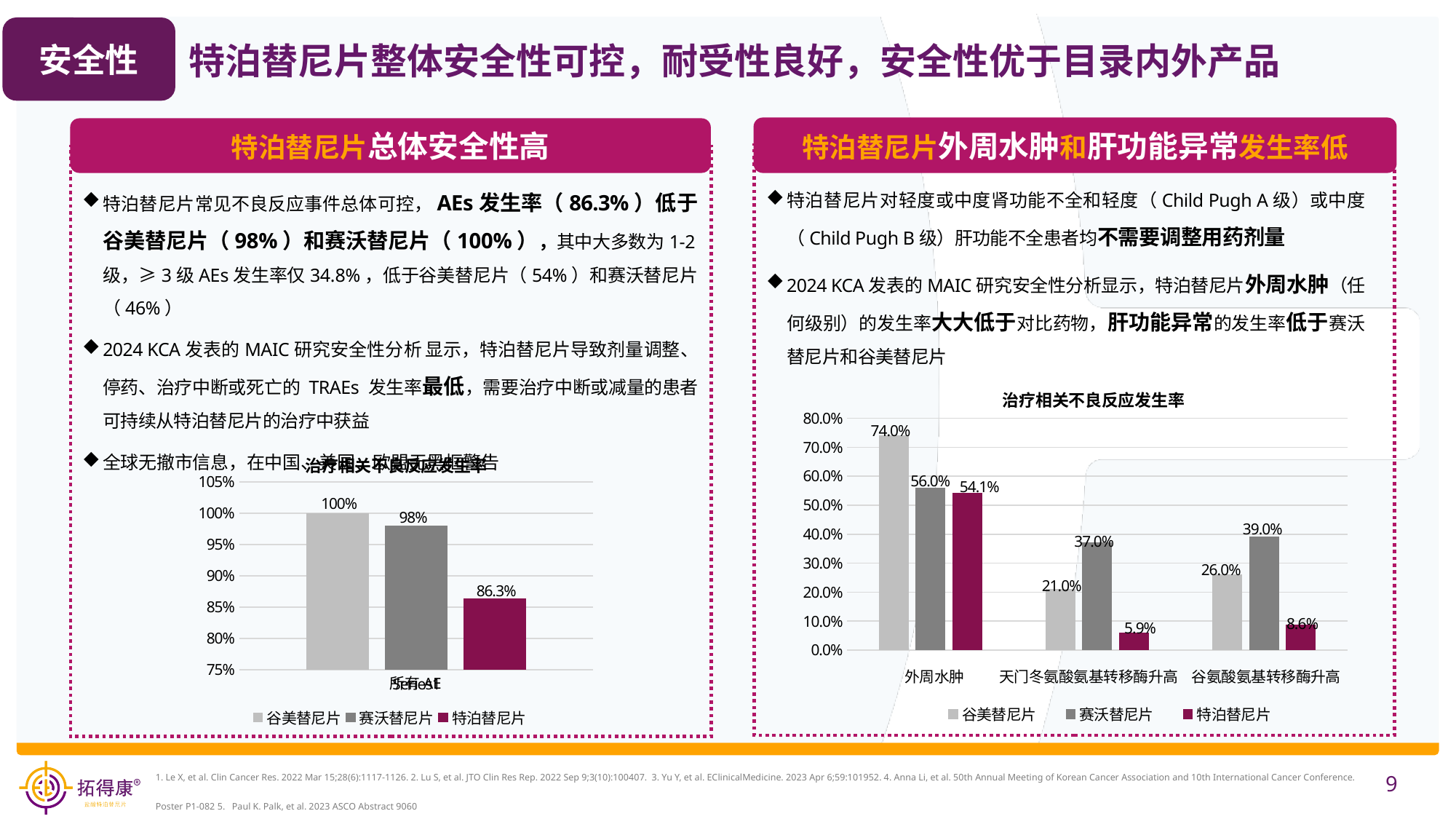
In the right chart, what is the value for 特泊替尼片 in the 外周水肿 category? 54.1% In the right chart, what is the value for 赛沃替尼片 in the 谷氨酸氨基转移酶升高 category? 39.0% In the right chart, what is the difference between 谷美替尼片 and 特泊替尼片 in the 外周水肿 category? 19.9% In the left chart, what is the value for 特泊替尼片? 86.3% In the left chart, what is the difference between the values for 谷美替尼片 and 特泊替尼片? 13.7% In the right chart, which series has the lowest value in the 天门冬氨酸氨基转移酶升高 category? 特泊替尼片 In the left chart, how many series does the legend list? 3 In the right chart, which series has the highest value in the 外周水肿 category? 谷美替尼片 In the left chart, which series has the highest value? 谷美替尼片 What kind of chart is the right chart? bar chart In the right chart, how many categories are shown on the x axis? 3 In the right chart, which is larger in the 谷氨酸氨基转移酶升高 category: 谷美替尼片 or 赛沃替尼片? 赛沃替尼片